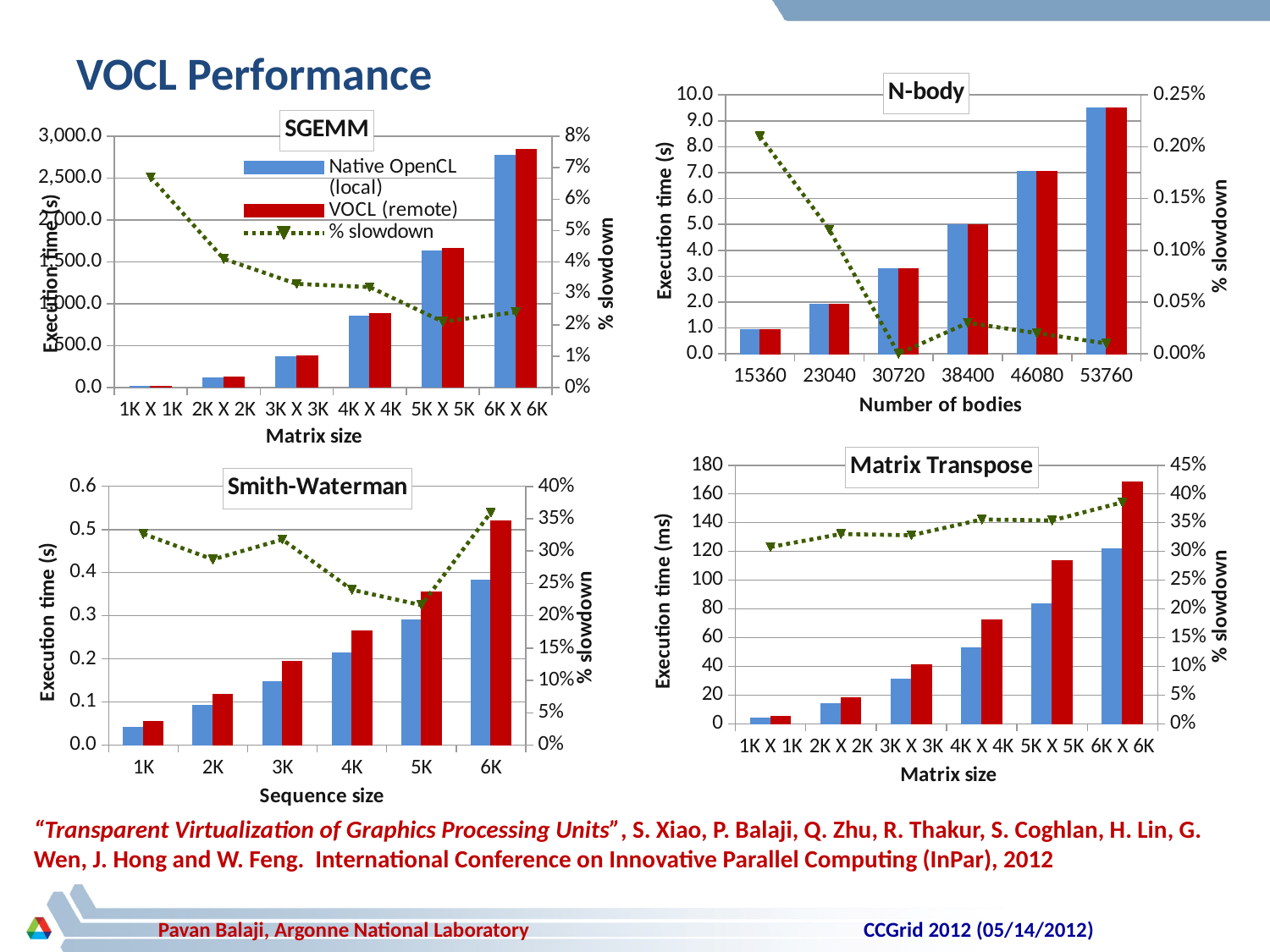
In the Matrix Transpose chart, which is larger at 4K X 4K: the Native OpenCL (local) bar or the VOCL (remote) bar? VOCL (remote) In the Smith-Waterman chart, is the VOCL (remote) execution time for 6K greater or less than 0.5? greater In the N-body chart, is the Native OpenCL execution time for 53760 bodies greater or less than 9.0? greater In the SGEMM chart, does the % slowdown line rise or fall as matrix size increases? fall In the SGEMM chart, how many matrix sizes are shown on the x axis? 6 In the Smith-Waterman chart, which sequence size has the highest % slowdown? 6K In the N-body chart, which number of bodies has the lowest % slowdown? 30720 In the SGEMM chart, how many series does the legend list? 3 In the SGEMM chart, which matrix size has the highest execution time? 6K X 6K In the SGEMM chart, is the VOCL (remote) execution time for 6K X 6K greater or less than 2,500.0? greater In the Matrix Transpose chart, what unit is the execution time axis in? ms In the N-body chart, do the execution time bars rise or fall as the number of bodies increases? rise